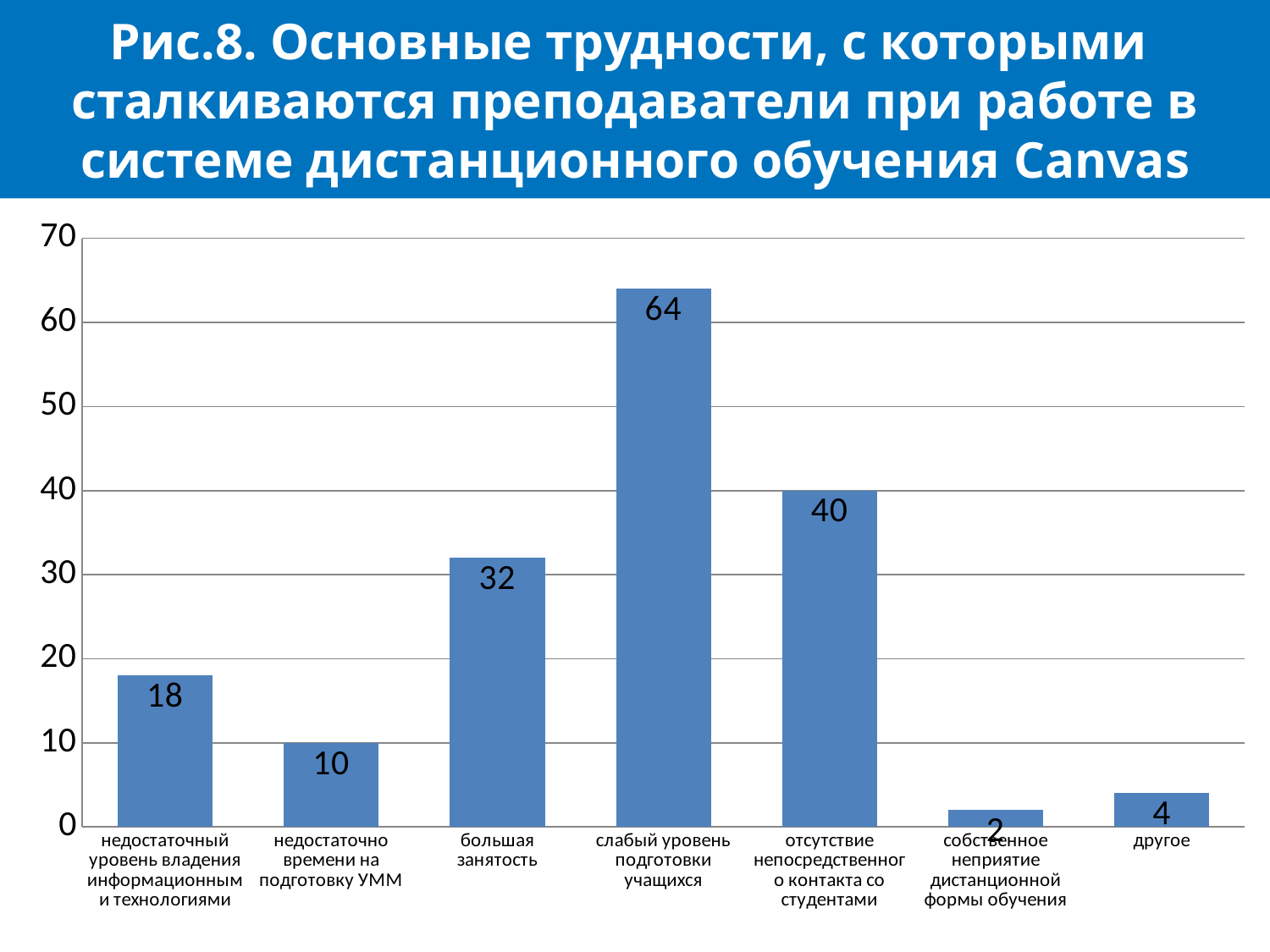
How many categories are shown on the chart? 7 What is the difference between the values for "слабый уровень подготовки учащихся" and "отсутствие непосредственного контакта со студентами"? 24 What is the value for "другое"? 4 Which category has the lowest value? собственное неприятие дистанционной формы обучения What is the highest value shown on the vertical axis? 70 What is the value for "большая занятость"? 32 What is the value for "отсутствие непосредственного контакта со студентами"? 40 What is the value for "недостаточно времени на подготовку УММ"? 10 Which is larger: the value for "недостаточный уровень владения информационными технологиями" or the value for "недостаточно времени на подготовку УММ"? недостаточный уровень владения информационными технологиями What kind of chart is shown on the slide? bar chart Is the value for "большая занятость" greater or less than 30? greater Which category has the highest value? слабый уровень подготовки учащихся